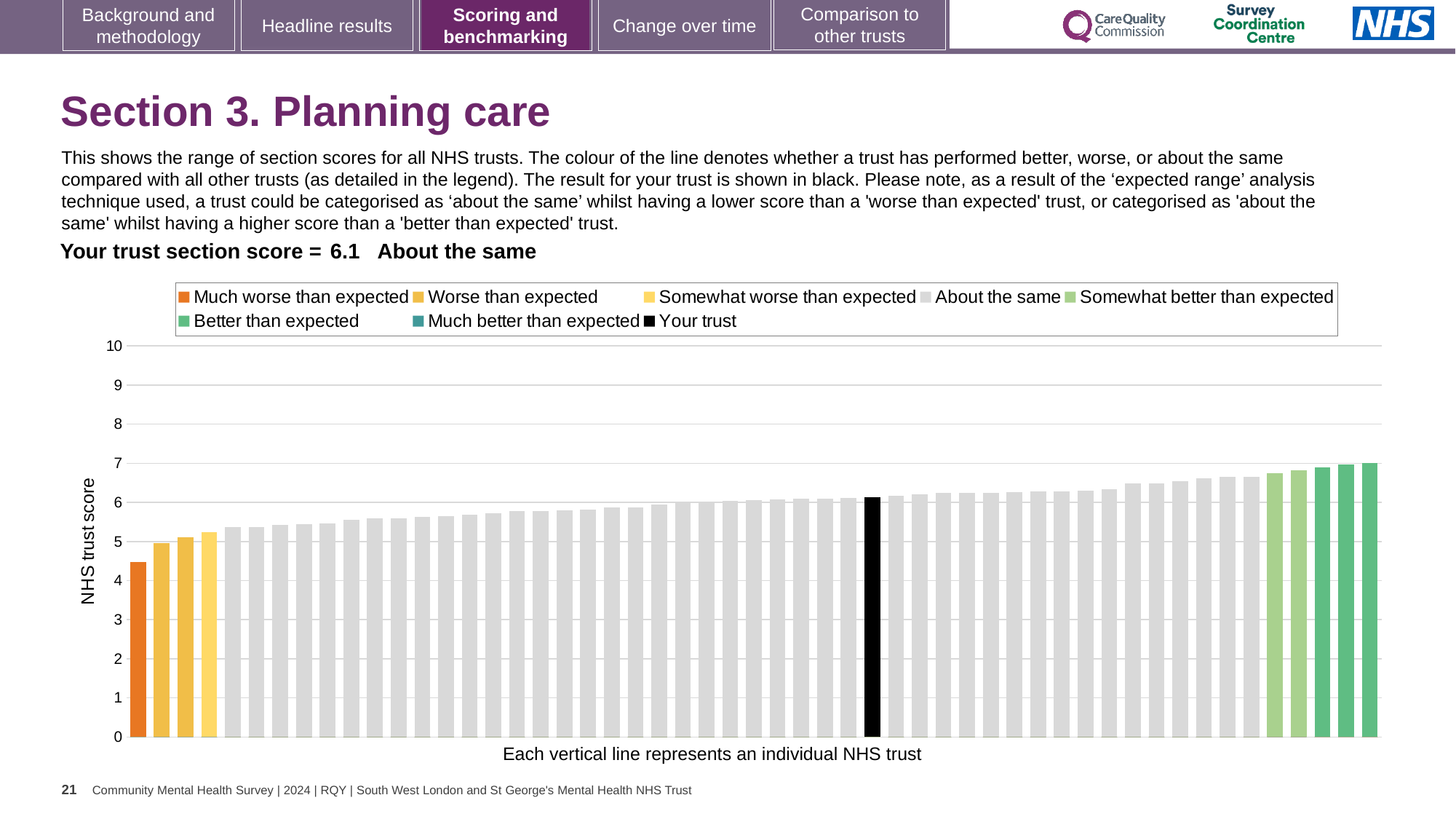
How is your trust's score categorised compared with other trusts? About the same Which is larger: the score for your trust (black bar) or the score of the leftmost orange bar? your trust What kind of chart is shown on the slide? bar chart What is the label on the vertical axis of the chart? NHS trust score Which legend category do the highest bars on the chart belong to? Better than expected Is the value of the black 'Your trust' bar greater or less than 6? greater Is the value of the leftmost (orange) bar greater or less than 5? less What colour is used to show your trust's bar? black What is the section score for your trust shown on the slide? 6.1 Which legend category does the lowest bar on the chart belong to? Much worse than expected How many entries does the chart legend list? 8 Do the bar values rise or fall from left to right along the x axis? rise